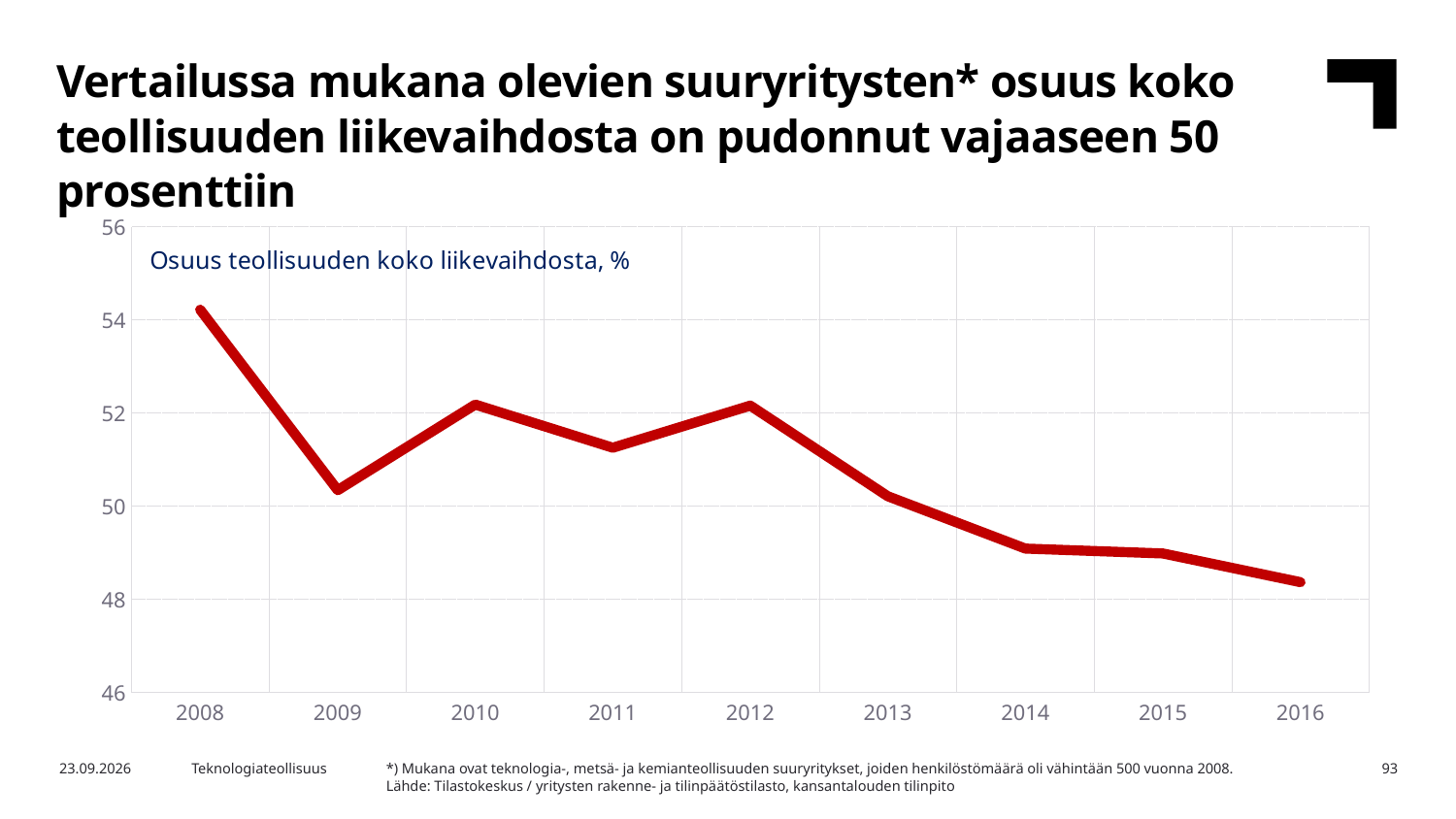
How many years are plotted on the x axis of the chart? 9 Is the value for 2011 greater or less than 50? greater Overall, do the values rise or fall from 2008 to 2016? fall Which year has the lowest value in the chart? 2016 What kind of chart is shown on the slide? line chart Which is larger, the value for 2008 or the value for 2016? 2008 Is the value for 2014 greater or less than 50? less Is the value for 2008 greater or less than 52? greater Which year has the highest value in the chart? 2008 Which is larger, the value for 2009 or the value for 2011? 2011 What is the label shown inside the chart area describing the plotted series? Osuus teollisuuden koko liikevaihdosta, %